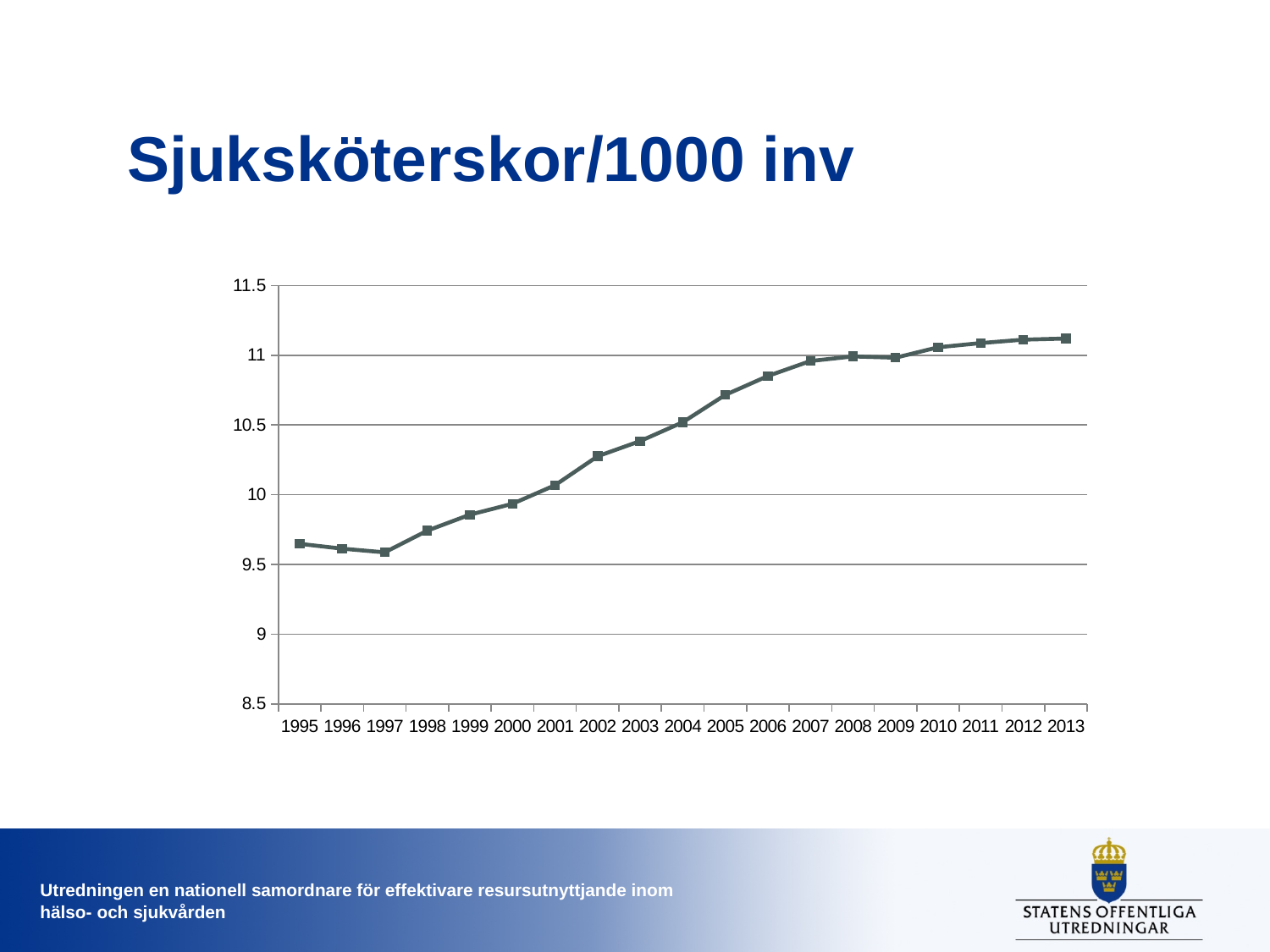
How many years are plotted along the x axis? 19 Is the value for 2013 greater or less than 11? greater Which year has the larger value, 1997 or 2003? 2003 Is the value for 1995 greater or less than 10? less What is the highest value shown on the y axis? 11.5 What kind of chart is shown on the slide? line chart What is the title of the chart? Sjuksköterskor/1000 inv Which year has the larger value, 2000 or 2005? 2005 Do the values generally rise or fall from 1995 to 2013? rise